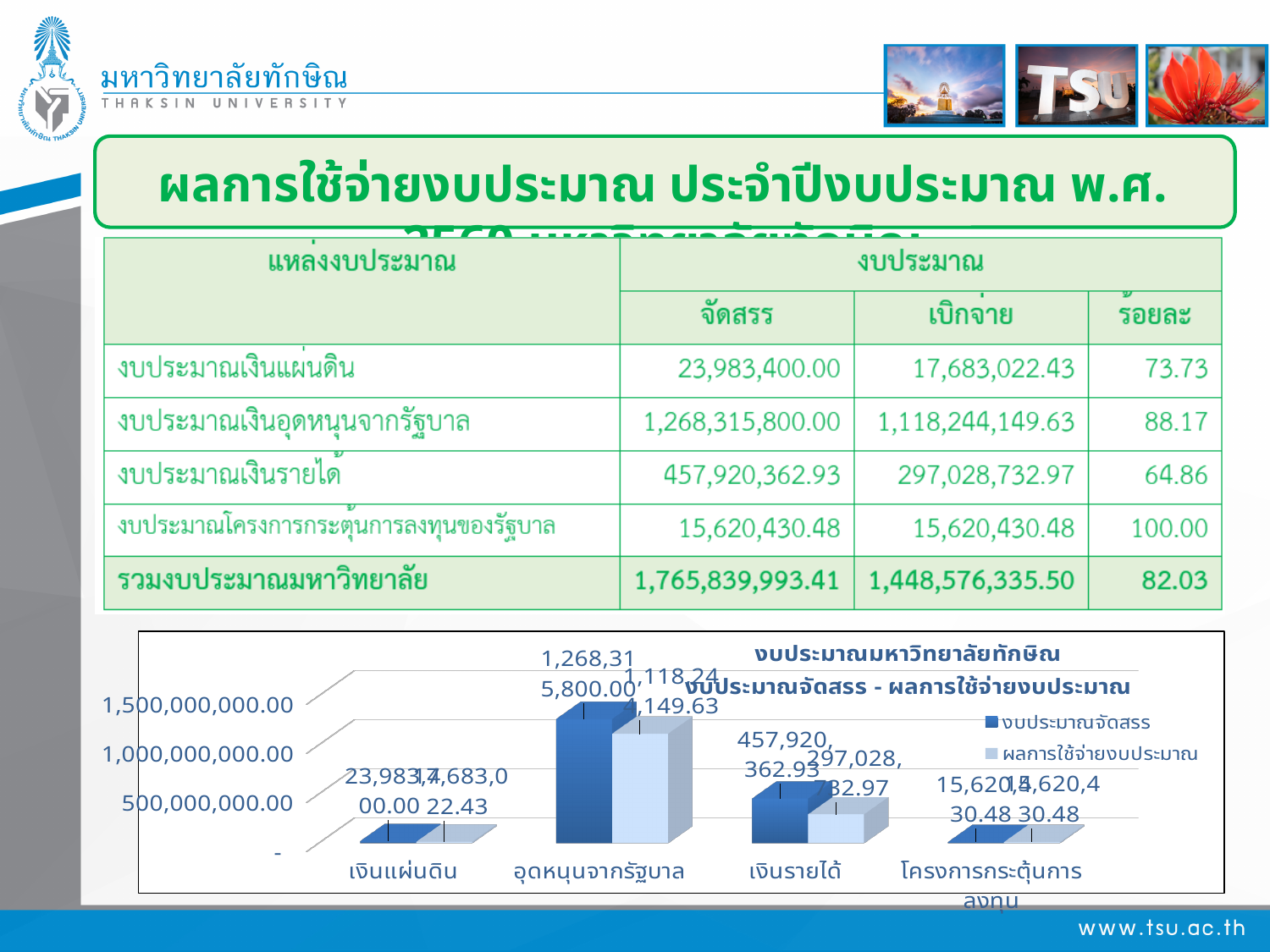
What type of chart is shown on the slide? Bar chart What is the value of ผลการใช้จ่ายงบประมาณ for เงินรายได้ in the chart? 297,028,732.97 Is the งบประมาณจัดสรร value for อุดหนุนจากรัฐบาล greater or less than 1,000,000,000.00? greater Which category has the lowest งบประมาณจัดสรร value in the chart? โครงการกระตุ้นการลงทุน What is the value of ผลการใช้จ่ายงบประมาณ for โครงการกระตุ้นการลงทุน in the chart? 15,620,430.48 Which colour represents งบประมาณจัดสรร in the chart legend? Dark blue What is the value of งบประมาณจัดสรร for อุดหนุนจากรัฐบาล in the chart? 1,268,315,800.00 How many series does the chart legend list? 2 How many categories are shown on the x axis of the chart? 4 In the chart, which is larger for เงินรายได้: งบประมาณจัดสรร or ผลการใช้จ่ายงบประมาณ? งบประมาณจัดสรร Which category has the highest งบประมาณจัดสรร value in the chart? อุดหนุนจากรัฐบาล In the chart, what is the difference between งบประมาณจัดสรร and ผลการใช้จ่ายงบประมาณ for อุดหนุนจากรัฐบาล? 150,071,650.37